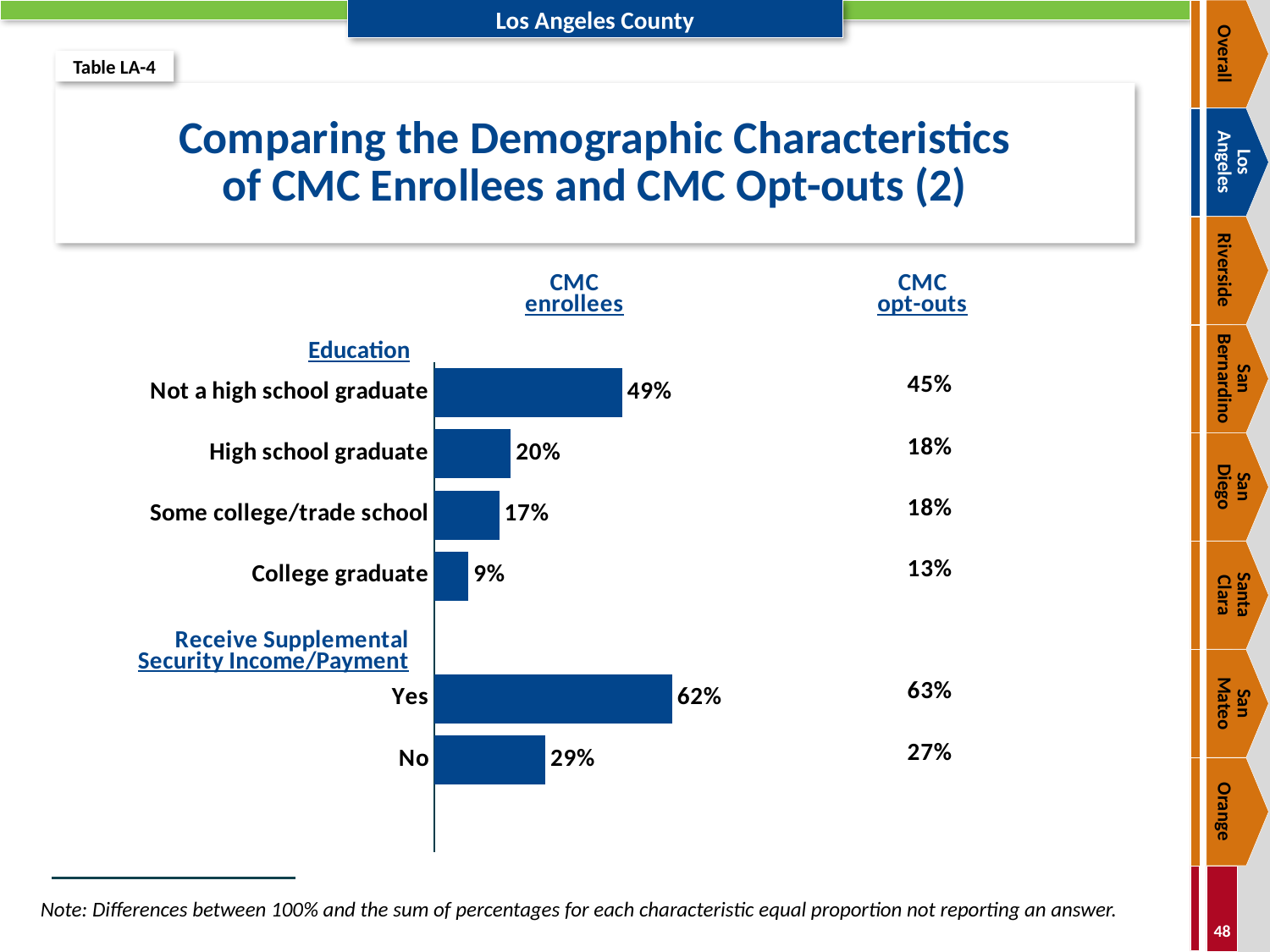
What percentage of CMC opt-outs answered No to receiving Supplemental Security Income/Payment? 27% Which education category has the highest percentage among CMC enrollees? Not a high school graduate Which education category has the lowest percentage among CMC enrollees? College graduate How many education categories are shown in the chart? 4 What is the difference between the CMC enrollees and CMC opt-outs percentages for Not a high school graduate? 4 percentage points What is the title of the slide's chart? Comparing the Demographic Characteristics of CMC Enrollees and CMC Opt-outs (2) What percentage of CMC enrollees receive Supplemental Security Income/Payment (Yes)? 62% What type of chart is used to show the CMC enrollees percentages? Bar chart What percentage of CMC opt-outs are college graduates? 13% Which is larger for High school graduate: the CMC enrollees percentage or the CMC opt-outs percentage? CMC enrollees What is the difference between the Yes and No percentages for CMC enrollees receiving Supplemental Security Income/Payment? 33 percentage points What percentage of CMC enrollees are not a high school graduate? 49%